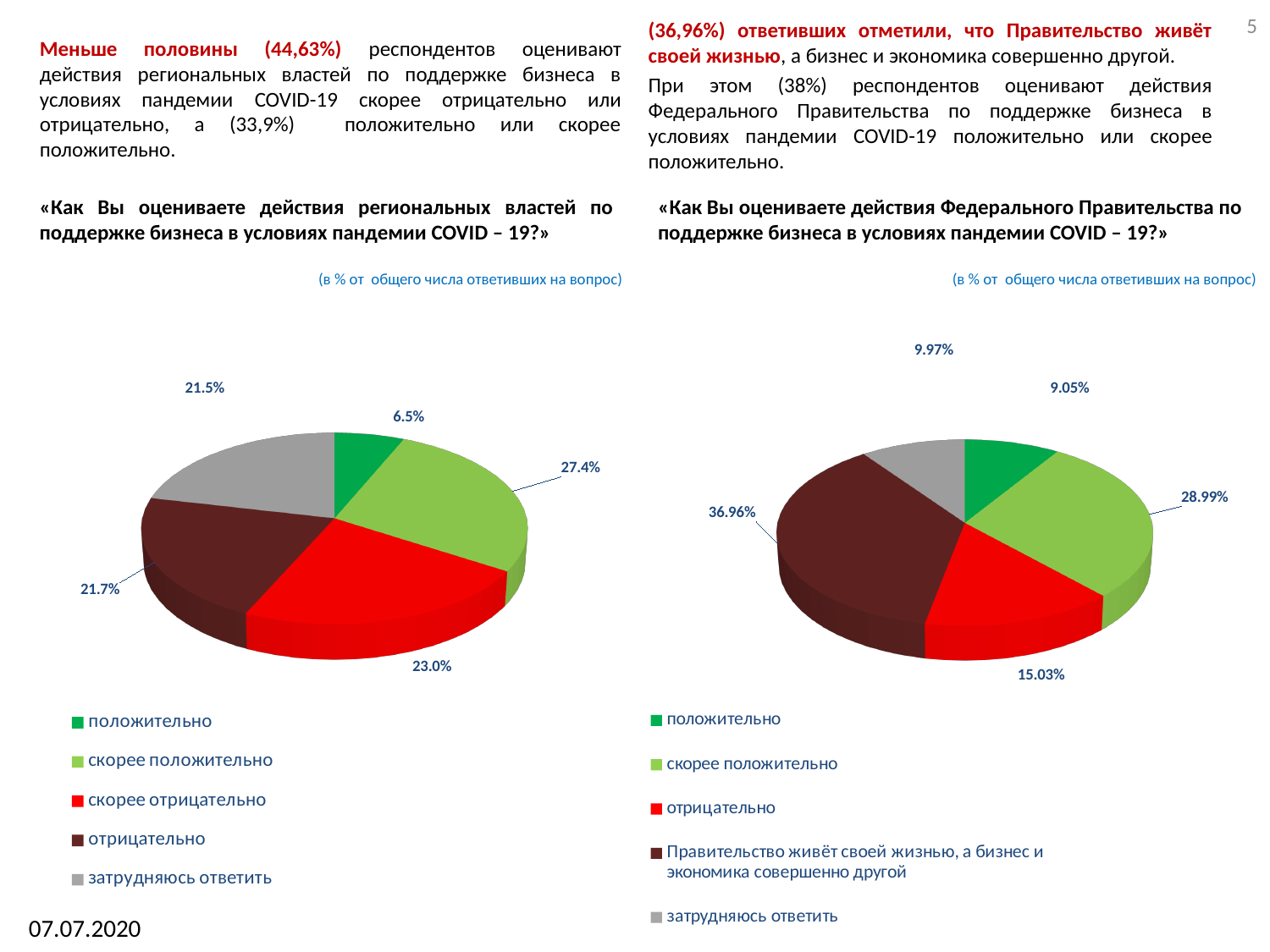
In the right pie chart (Federal Government), which answer option has the largest share? Правительство живёт своей жизнью, а бизнес и экономика совершенно другой In the right pie chart (Federal Government), what share of respondents chose «Правительство живёт своей жизнью, а бизнес и экономика совершенно другой»? 36.96% In the right pie chart (Federal Government), what share of respondents answered «отрицательно»? 15.03% In the left pie chart (regional authorities), which answer option has the smallest share? положительно In the right pie chart (Federal Government), what is the combined share of «положительно» and «скорее положительно»? 38.04% In the left pie chart (regional authorities), which answer option has the largest share? скорее положительно In the left pie chart (regional authorities), what share of respondents answered «скорее положительно»? 27.4% In the left pie chart (regional authorities), what is the difference between the shares for «скорее отрицательно» and «отрицательно»? 1.3% What type of chart is used on this slide? Pie chart In the right pie chart (Federal Government), which is larger: the share for «положительно» or the share for «затрудняюсь ответить»? затрудняюсь ответить In the left pie chart (regional authorities), what share of respondents answered «положительно»? 6.5% How many answer options does the legend of the left pie chart list? 5